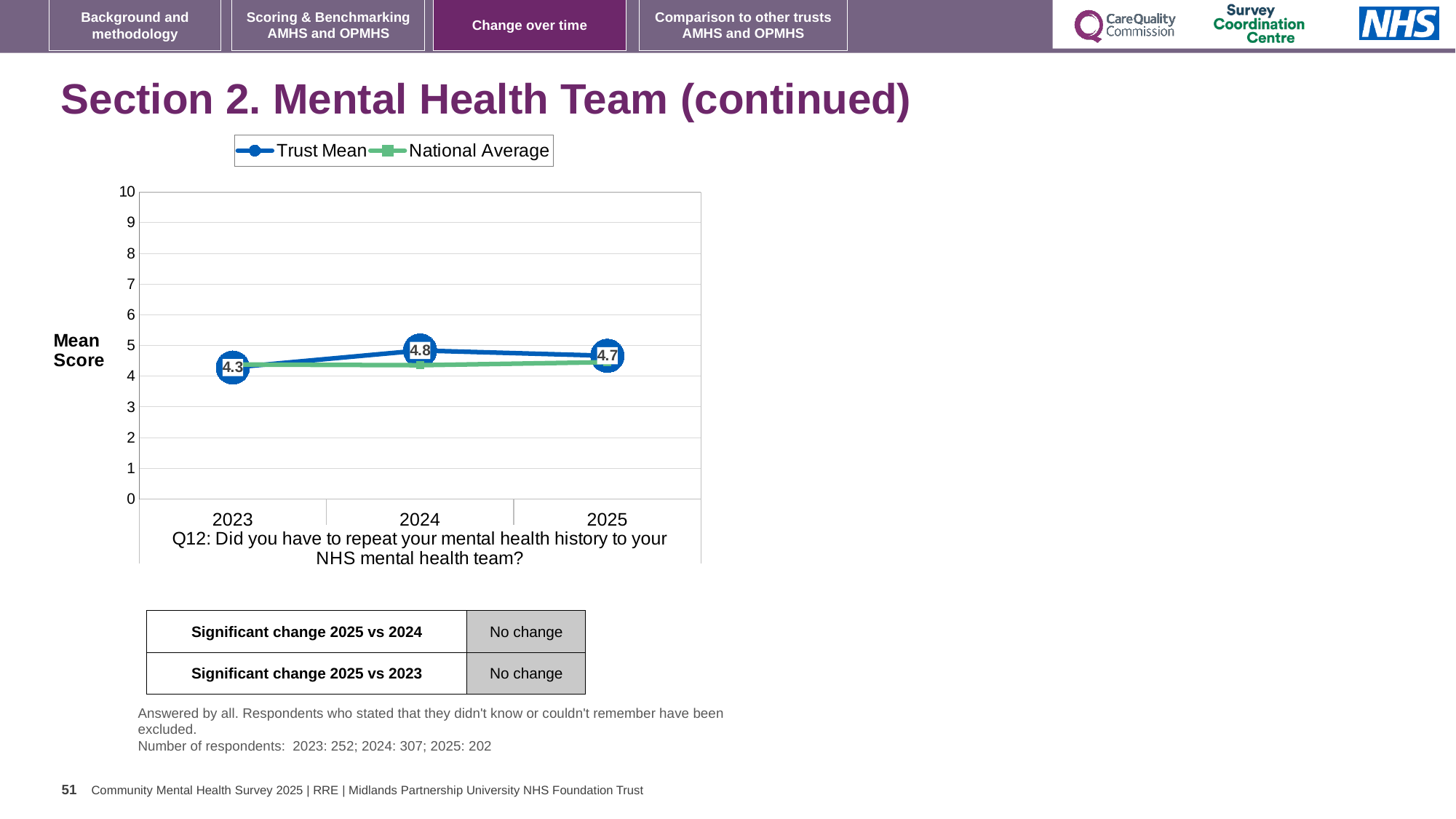
In which year was the Trust Mean lowest? 2023 What is the Trust Mean score for 2023? 4.3 How many years are plotted on the x axis? 3 What kind of chart is shown on the slide? line chart How many series does the legend list? 2 What is the Trust Mean score for 2024? 4.8 What is the difference between the Trust Mean in 2024 and in 2023? 0.5 Which is larger, the Trust Mean in 2025 or in 2023? 2025 What is the label on the y axis of the chart? Mean Score What is the Trust Mean score for 2025? 4.7 In which year was the Trust Mean highest? 2024 Is the National Average value for 2024 greater or less than 5? less